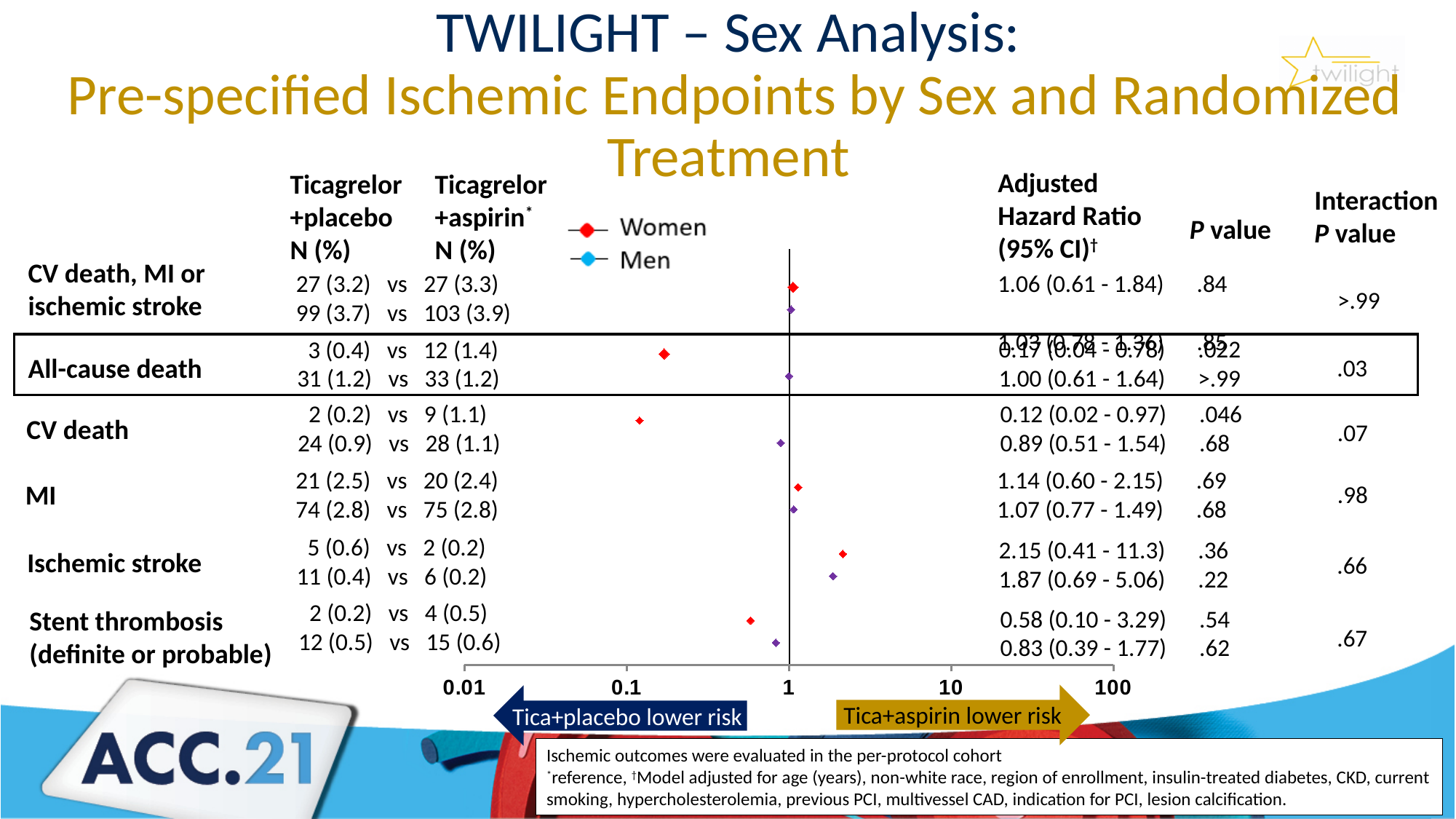
Which colour represents men in the legend? Blue What is the interaction P value for all-cause death? .03 For ischemic stroke, what is the difference between the women's and men's adjusted hazard ratios? 0.28 How many series does the legend list? 2 Which endpoint has the highest adjusted hazard ratio for women? Ischemic stroke What is the adjusted hazard ratio for men for ischemic stroke? 1.87 (0.69 - 5.06) How many endpoints are plotted in the forest plot? 6 What is the P value for the women's hazard ratio for MI? .69 Is the women's hazard ratio for CV death greater or less than 1? less What is the adjusted hazard ratio for women for CV death? 0.12 (0.02 - 0.97) For MI, is the adjusted hazard ratio larger for women or for men? Women Which endpoint has the lowest adjusted hazard ratio for men? Stent thrombosis (definite or probable)